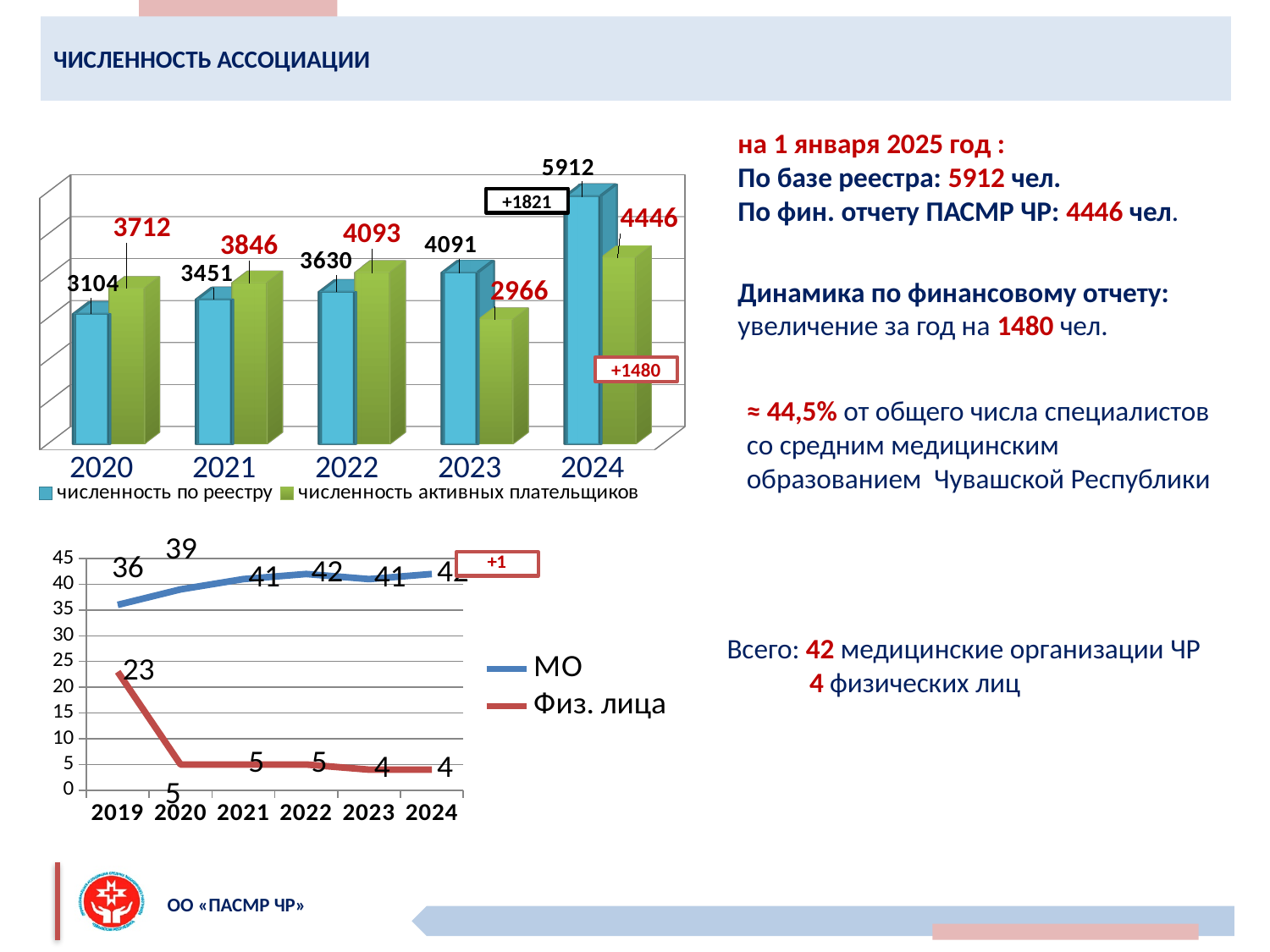
In the top bar chart, what is the difference between численность по реестру in 2024 and in 2023? 1821 In the bottom line chart, how many series does the legend list? 2 In the top bar chart, what is the value for численность активных плательщиков in 2023? 2966 In the bottom line chart, does the value for Физ. лица rise or fall from 2019 to 2024? fall In the bottom line chart, what is the value for МО in 2021? 41 In the top bar chart, which is larger in 2022: численность по реестру or численность активных плательщиков? численность активных плательщиков In the top bar chart, what is the value for численность по реестру in 2024? 5912 In the bottom line chart, what is the value for Физ. лица in 2019? 23 In the top bar chart, which year has the highest value for численность по реестру? 2024 In the top bar chart, how many years are shown on the x axis? 5 What type of chart is the top chart on the slide? bar chart In the top bar chart, which year has the lowest value for численность активных плательщиков? 2023